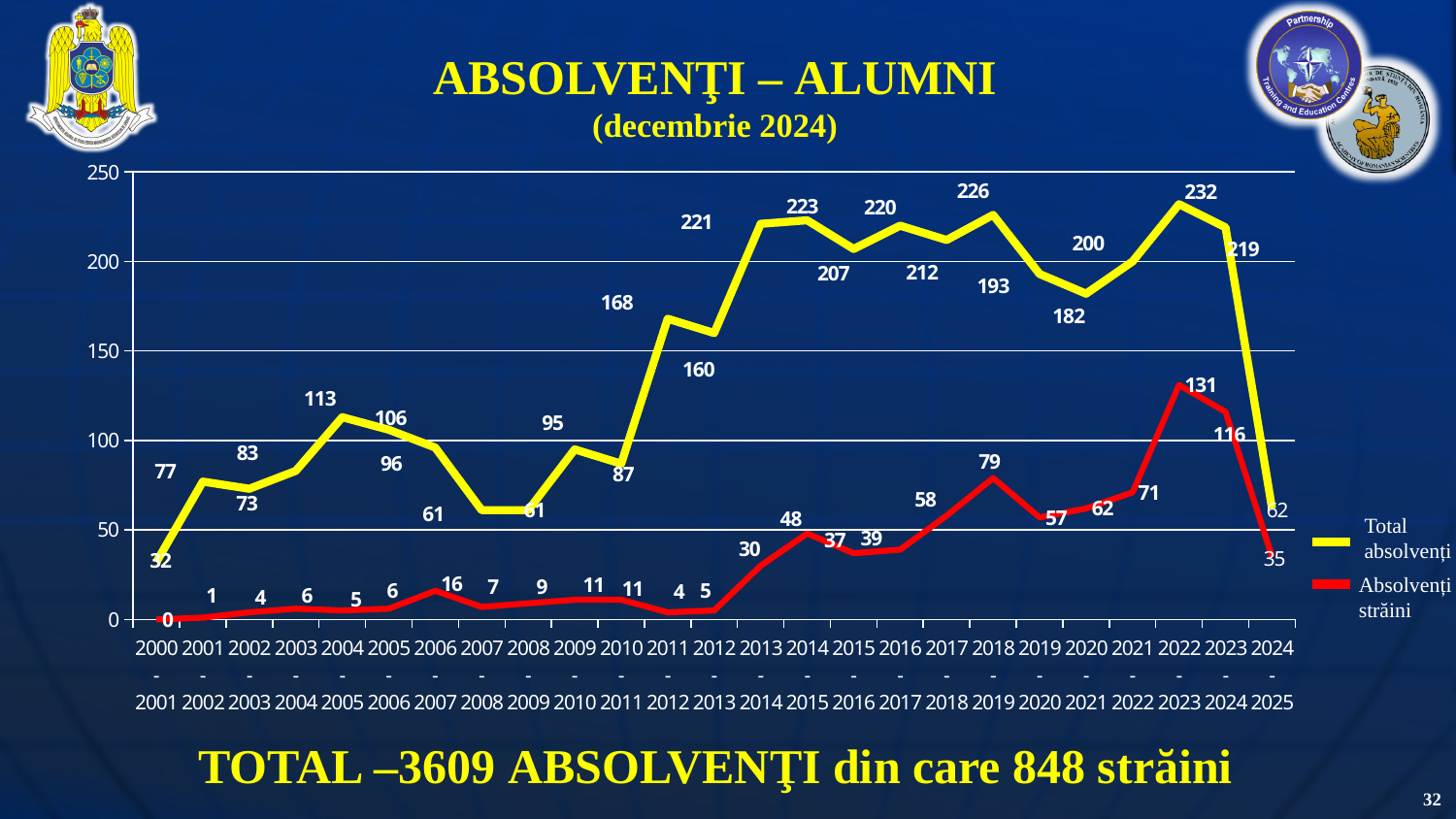
What kind of chart is shown on the slide? line chart How many series does the legend list? 2 What is the value of Absolvenți străini for 2024-2025? 35 What colour is the line for Absolvenți străini? red In which academic year is Total absolvenți highest? 2022-2023 What is the value of Total absolvenți for 2013-2014? 221 Does Total absolvenți rise or fall from 2022-2023 to 2024-2025? fall What is the difference between Total absolvenți and Absolvenți străini in 2022-2023? 101 Which is larger: Total absolvenți in 2011-2012 or in 2012-2013? 2011-2012 What is the value of Absolvenți străini for 2018-2019? 79 In which academic year is Absolvenți străini lowest? 2000-2001 How many academic years are plotted on the x axis? 25